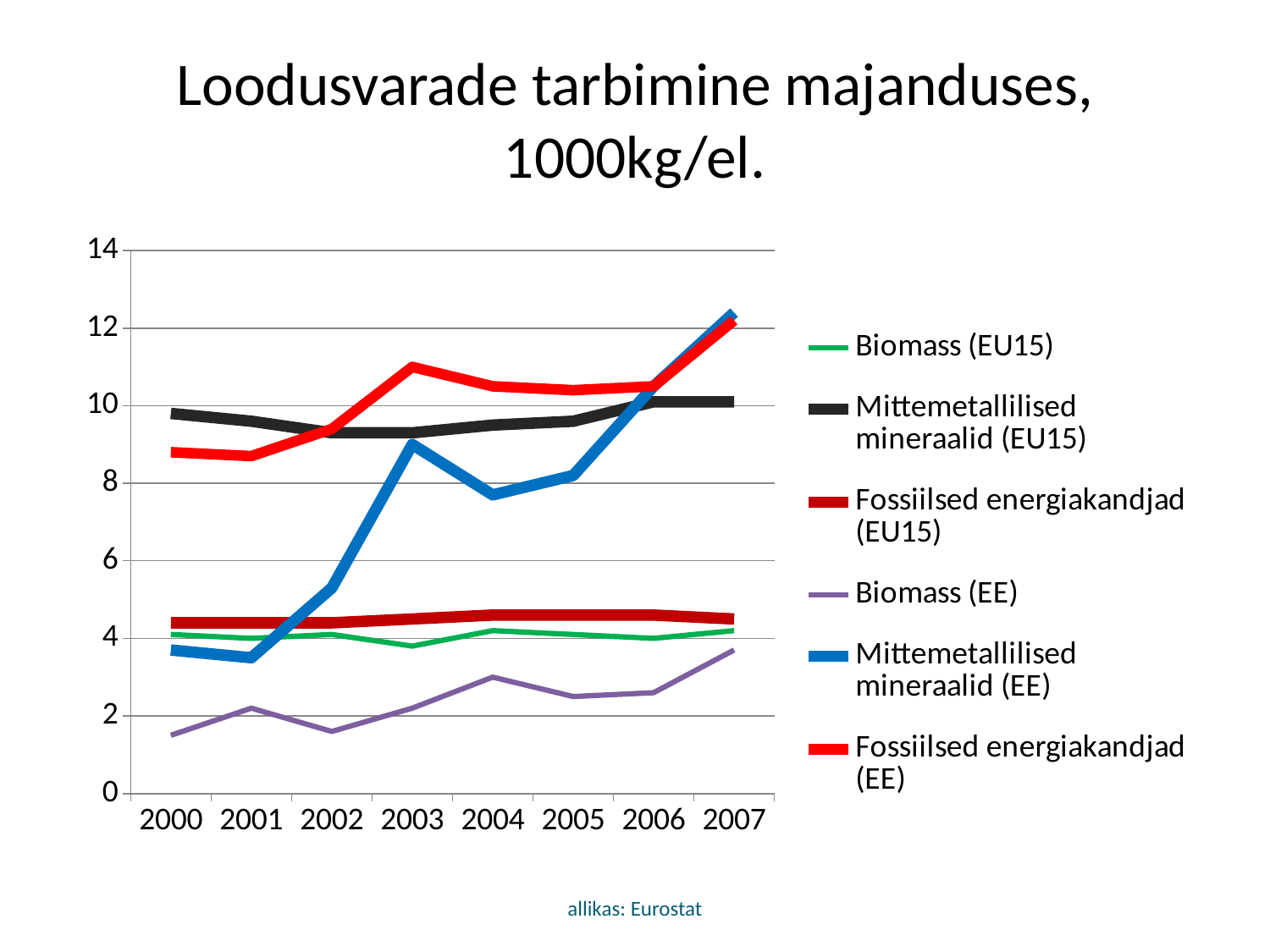
What is the title of the chart? Loodusvarade tarbimine majanduses, 1000kg/el. Is the value for Mittemetallilised mineraalid (EE) in 2001 greater or less than 4? less How many series does the legend list? 6 Does the Mittemetallilised mineraalid (EE) line rise or fall overall from 2000 to 2007? rise Does the Biomass (EE) line rise or fall overall from 2000 to 2007? rise In 2000, which is higher: Mittemetallilised mineraalid (EU15) or Fossiilsed energiakandjad (EE)? Mittemetallilised mineraalid (EU15) Is the value for Mittemetallilised mineraalid (EE) in 2003 greater or less than 8? greater What kind of chart is shown on the slide? line chart Is the value for Fossiilsed energiakandjad (EE) in 2003 greater or less than 10? greater How many years are shown on the x axis? 8 Which series has the lowest value in 2000? Biomass (EE)